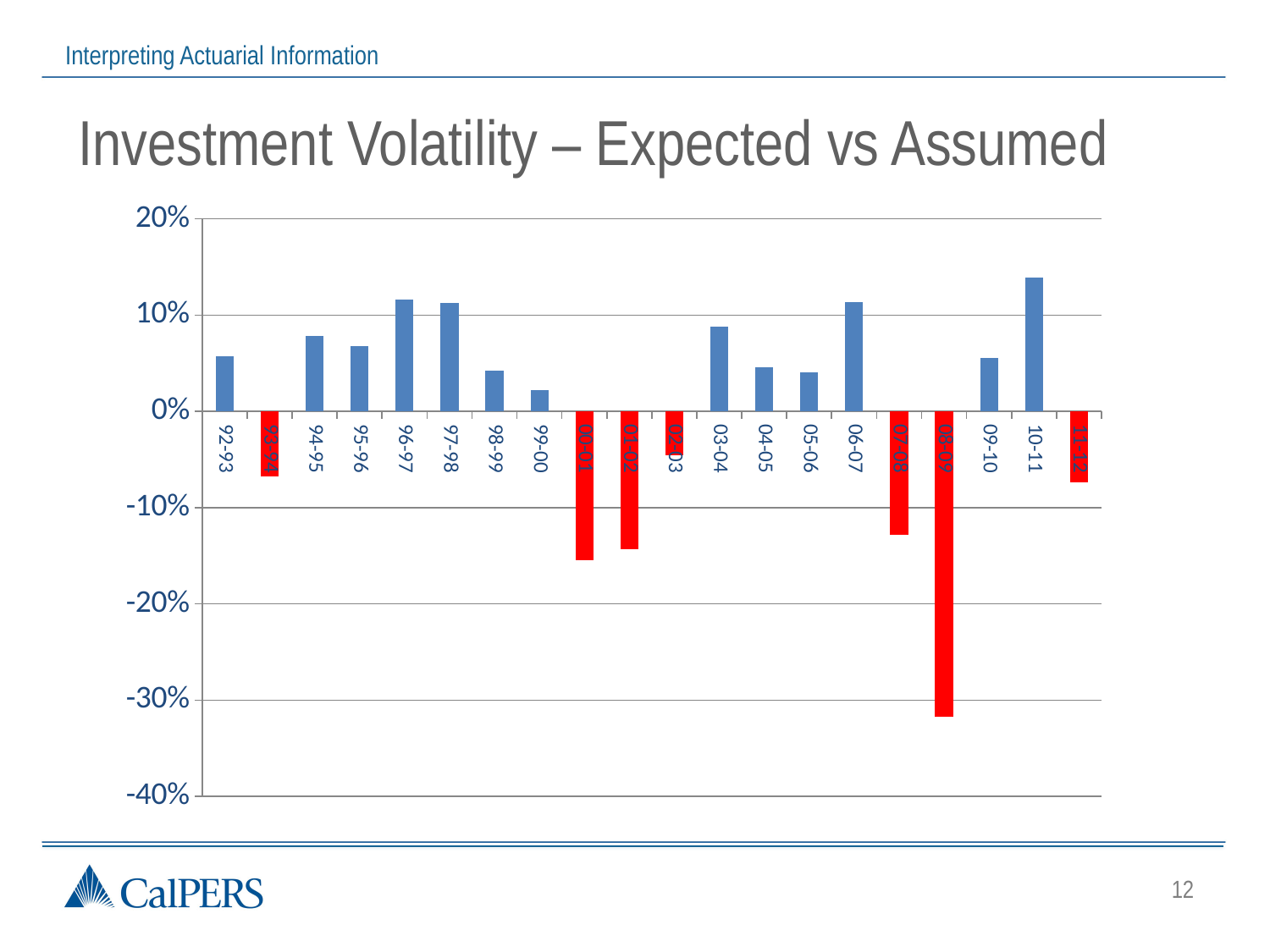
Is the value for 08-09 greater or less than -30%? less Which fiscal year has the lowest value on the chart? 08-09 Which is larger, the value for 96-97 or the value for 92-93? 96-97 What kind of chart is shown on the slide? bar chart Which is larger, the value for 02-03 or the value for 00-01? 02-03 Is the value for 00-01 greater or less than -10%? less Is the value for 96-97 greater or less than 10%? greater What is the title of the chart? Investment Volatility – Expected vs Assumed What colour are the bars with negative values on the chart? red How many fiscal years (categories) are plotted on the chart? 20 Which fiscal year has the highest value on the chart? 10-11